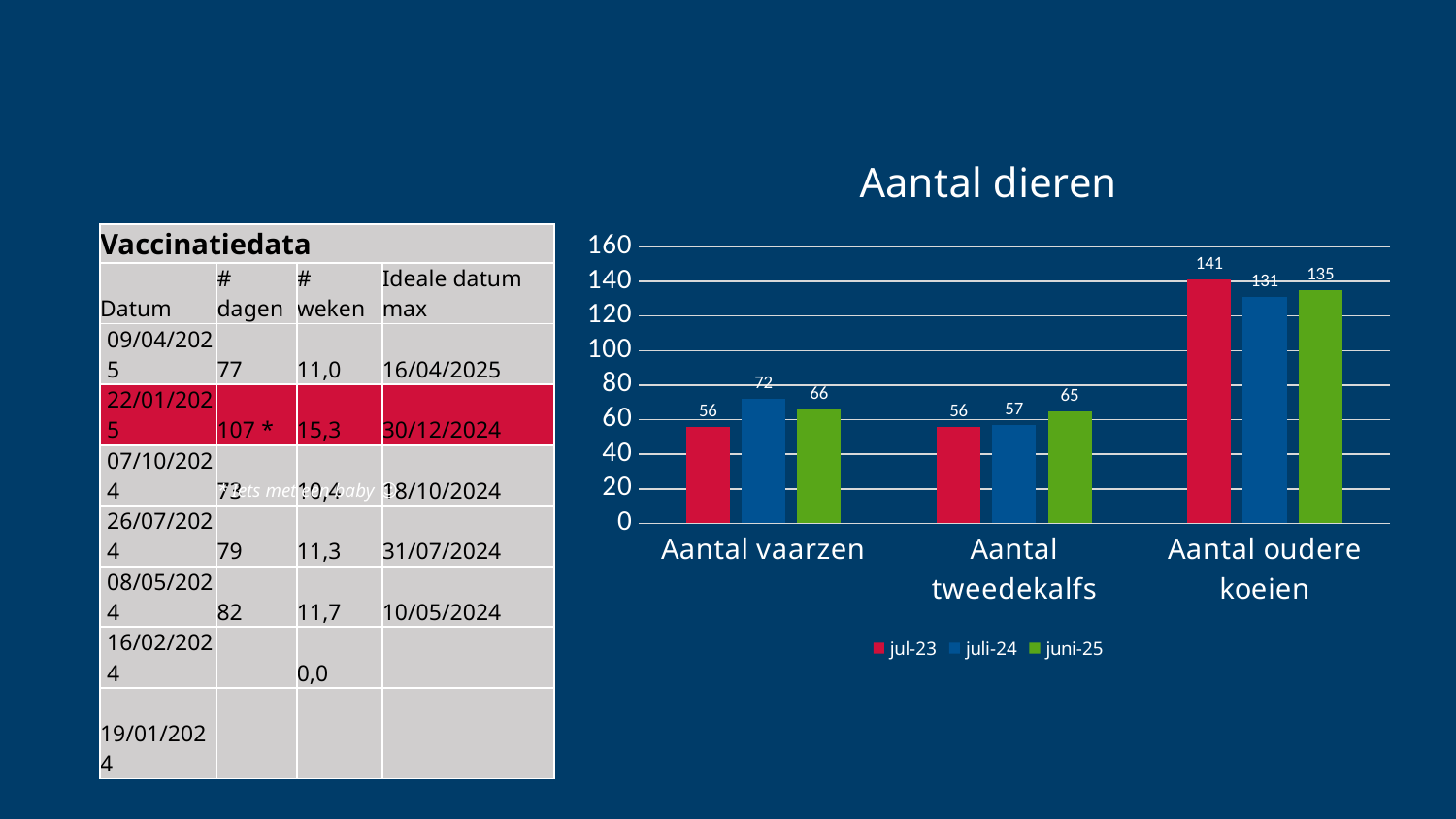
Which series has the lowest value in the Aantal vaarzen category? jul-23 What kind of chart is shown on the slide? bar chart What is the value for juni-25 in the Aantal oudere koeien category? 135 How many series does the legend list? 3 How many categories are shown on the x axis of the chart? 3 Is the value for juli-24 in Aantal oudere koeien greater or less than 120? greater Which is larger in the Aantal vaarzen category: juli-24 or juni-25? juli-24 What is the difference between the jul-23 and juli-24 values for Aantal oudere koeien? 10 What is the title of the chart? Aantal dieren Which category has the highest value for the jul-23 series? Aantal oudere koeien What is the value for juli-24 in the Aantal tweedekalfs category? 57 What is the value for jul-23 in the Aantal vaarzen category? 56